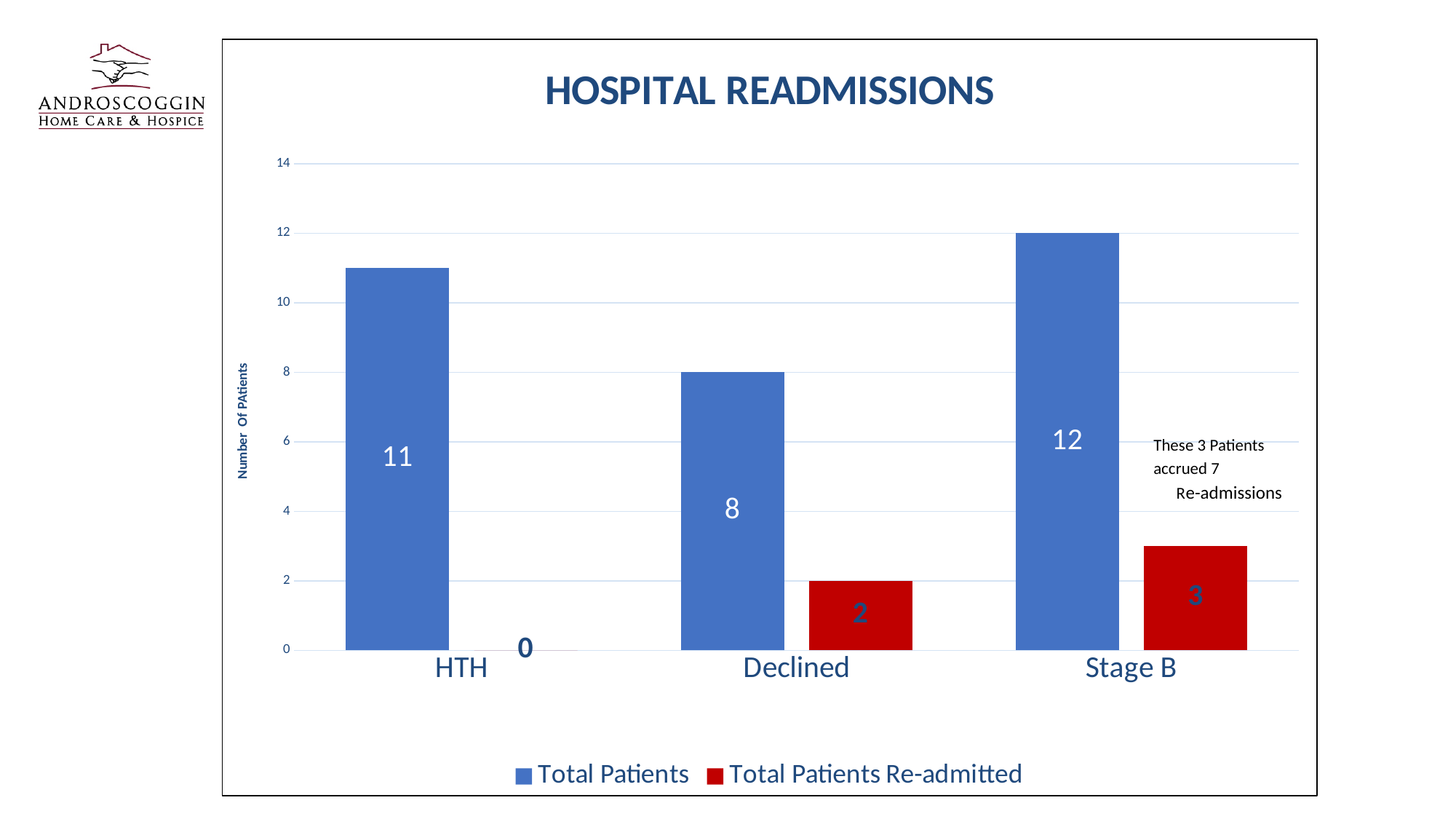
What is the Total Patients Re-admitted value for HTH? 0 What kind of chart is shown? Bar chart What is the Total Patients value for HTH? 11 Which category has the highest Total Patients value? Stage B What is the title of the chart? HOSPITAL READMISSIONS Which category has the lowest Total Patients value? Declined Which is larger, Total Patients for HTH or Total Patients for Declined? HTH What is the Total Patients Re-admitted value for Declined? 2 What is the Total Patients value for Stage B? 12 How many categories are shown on the x axis? 3 What is the difference between Total Patients and Total Patients Re-admitted for Stage B? 9 How many series does the legend list? 2